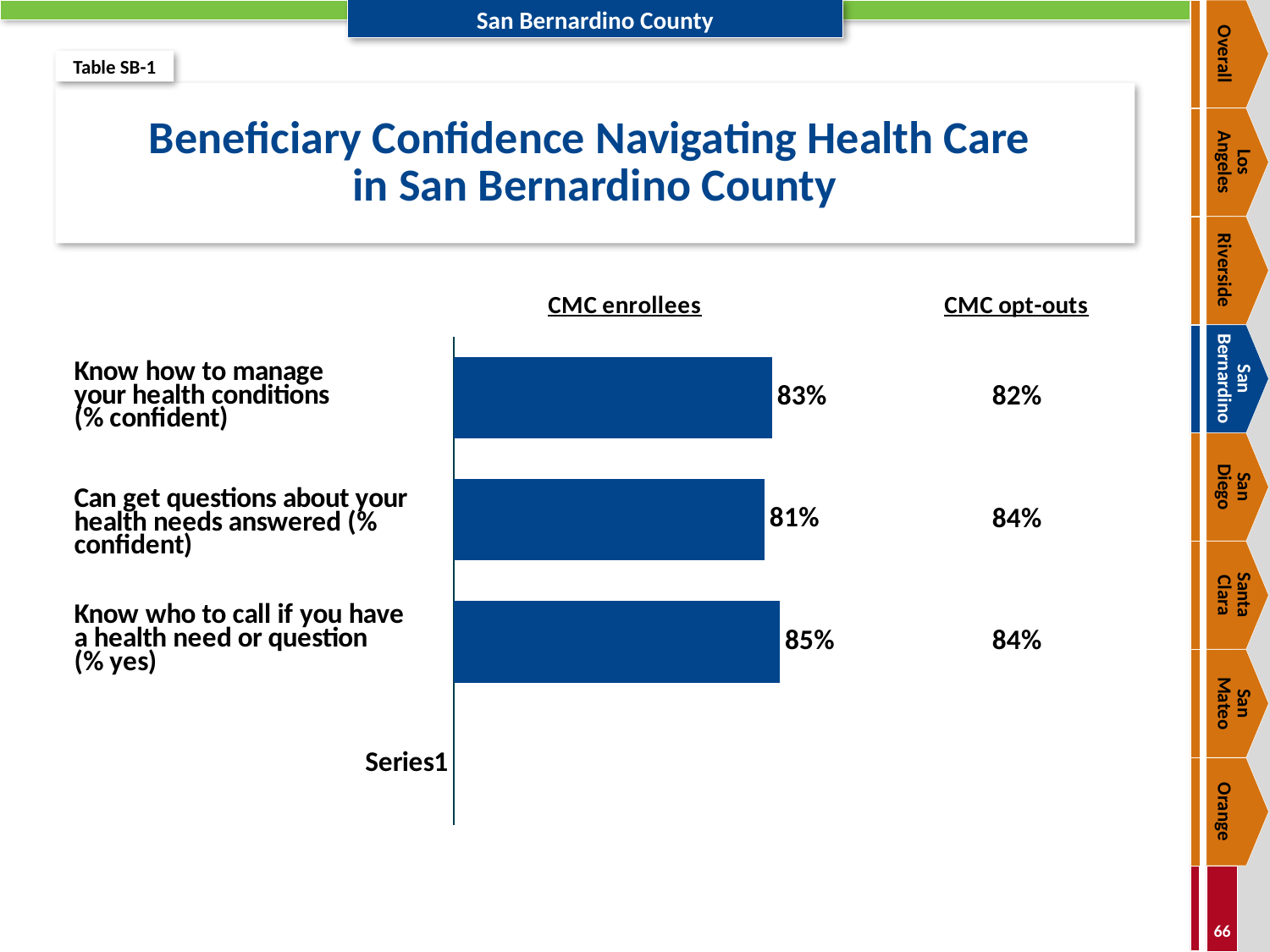
What percentage of CMC enrollees know how to manage their health conditions? 83% Which measure has the highest value for CMC enrollees? Know who to call if you have a health need or question What is the difference between the CMC enrollees value and the CMC opt-outs value for 'Can get questions about your health needs answered'? 3% For 'Know how to manage your health conditions', which group has the higher value, CMC enrollees or CMC opt-outs? CMC enrollees What is the title of the chart? Beneficiary Confidence Navigating Health Care in San Bernardino County What percentage of CMC enrollees can get questions about their health needs answered? 81% Which measure has the lowest value for CMC enrollees? Can get questions about your health needs answered How many measures are plotted as bars in the chart? 3 What kind of chart is shown on the slide? bar chart What percentage of CMC enrollees know who to call if they have a health need or question? 85% What percentage of CMC opt-outs know how to manage their health conditions? 82% What percentage of CMC opt-outs can get questions about their health needs answered? 84%